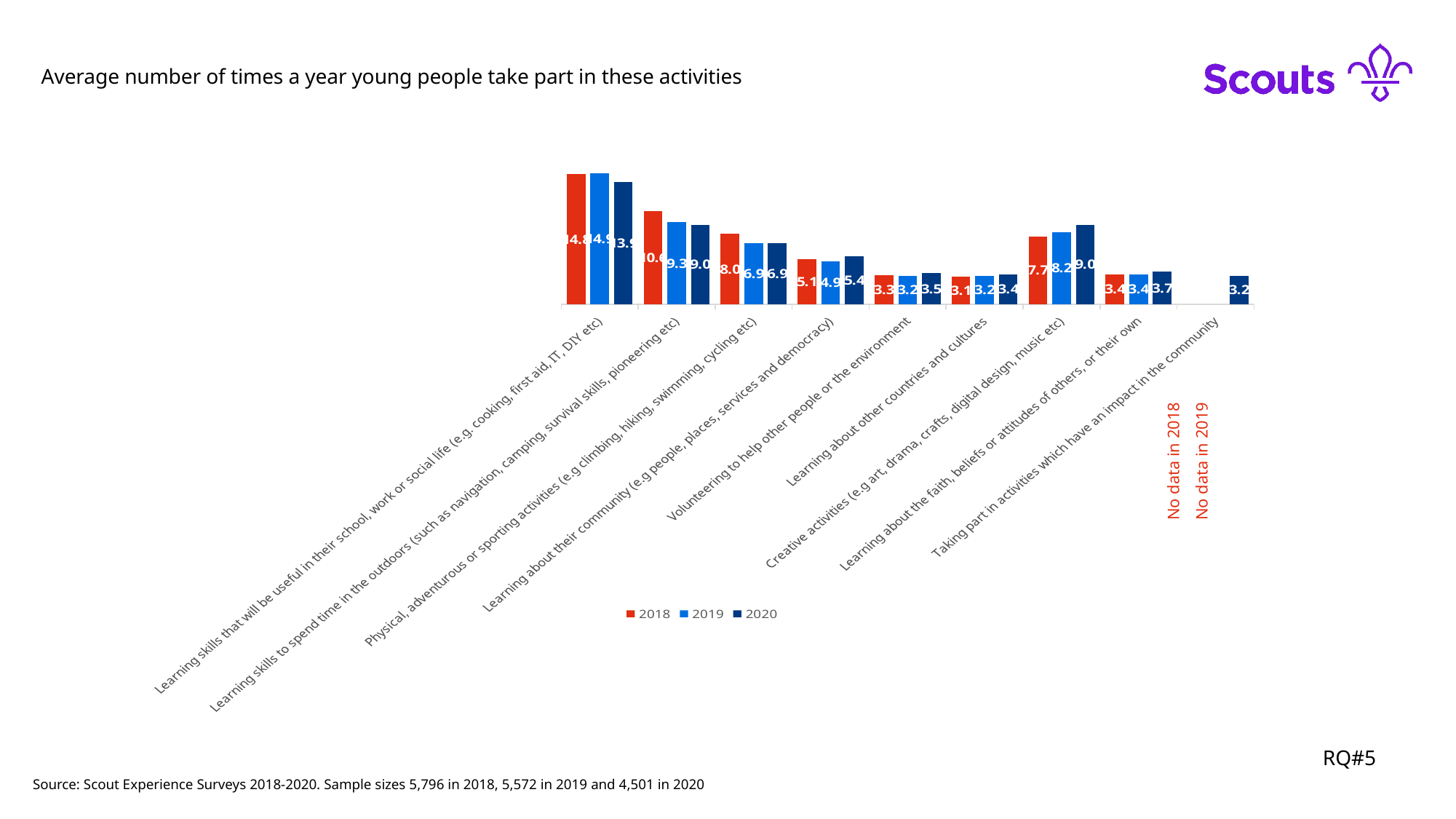
What is the 2018 value for 'Learning skills to spend time in the outdoors (such as navigation, camping, survival skills, pioneering etc)'? 10.6 What is the 2020 value for 'Creative activities (e.g art, drama, crafts, digital design, music etc)'? 9.0 What is the 2020 value for 'Taking part in activities which have an impact in the community'? 3.2 How many activity categories are shown on the x axis? 9 How many series does the legend list? 3 Which had the larger 2018 value: 'Physical, adventurous or sporting activities' or 'Creative activities'? Physical, adventurous or sporting activities For which years is there no data for 'Taking part in activities which have an impact in the community'? 2018 and 2019 What is the 2019 value for 'Learning about their community (e.g people, places, services and democracy)'? 4.9 By how much did the value for 'Creative activities' increase from 2018 to 2020? 1.3 What kind of chart is shown on the slide? bar chart Which activity has the highest 2020 value? Learning skills that will be useful in their school, work or social life (e.g. cooking, first aid, IT, DIY etc) Which activity has the lowest 2020 value? Taking part in activities which have an impact in the community